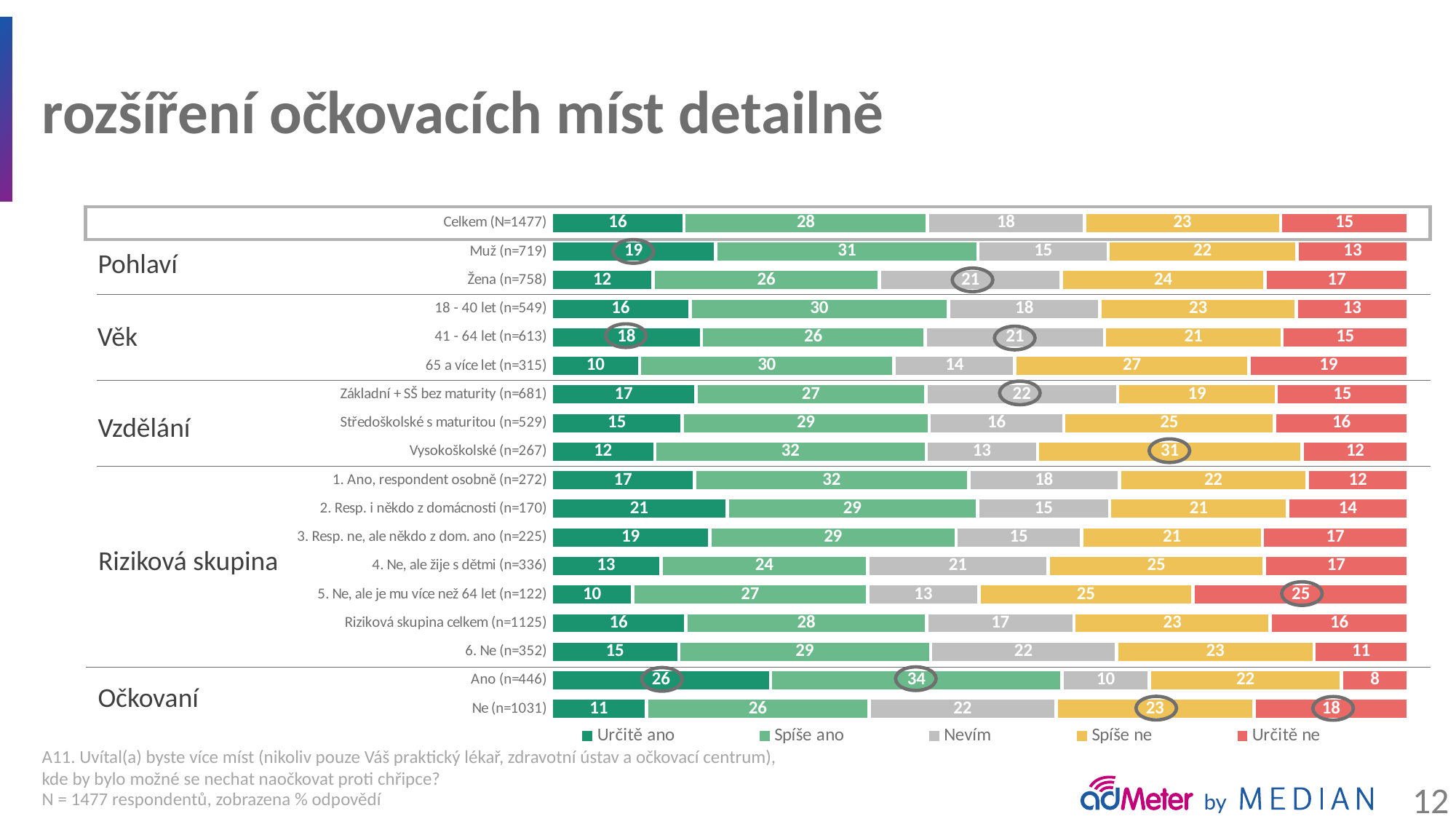
What type of chart is shown on the slide? stacked bar chart Which category has the highest 'Určitě ne' value? 5. Ne, ale je mu více než 64 let (n=122) How many series does the legend list? 5 Which is larger: the 'Spíše ano' value for Muž (n=719) or for Žena (n=758)? Muž (n=719) Which category has the lowest 'Určitě ne' value? Ano (n=446) How many category rows (bars) are plotted in the chart? 18 What is the 'Určitě ano' value for Muž (n=719)? 19 What is the 'Spíše ne' value for Vysokoškolské (n=267)? 31 What is the total of the 'Určitě ano' and 'Spíše ano' values for Celkem (N=1477)? 44 What is the 'Nevím' value for Žena (n=758)? 21 What is the difference between the 'Určitě ano' values for Ano (n=446) and Ne (n=1031)? 15 Which category has the highest 'Určitě ano' value? Ano (n=446)